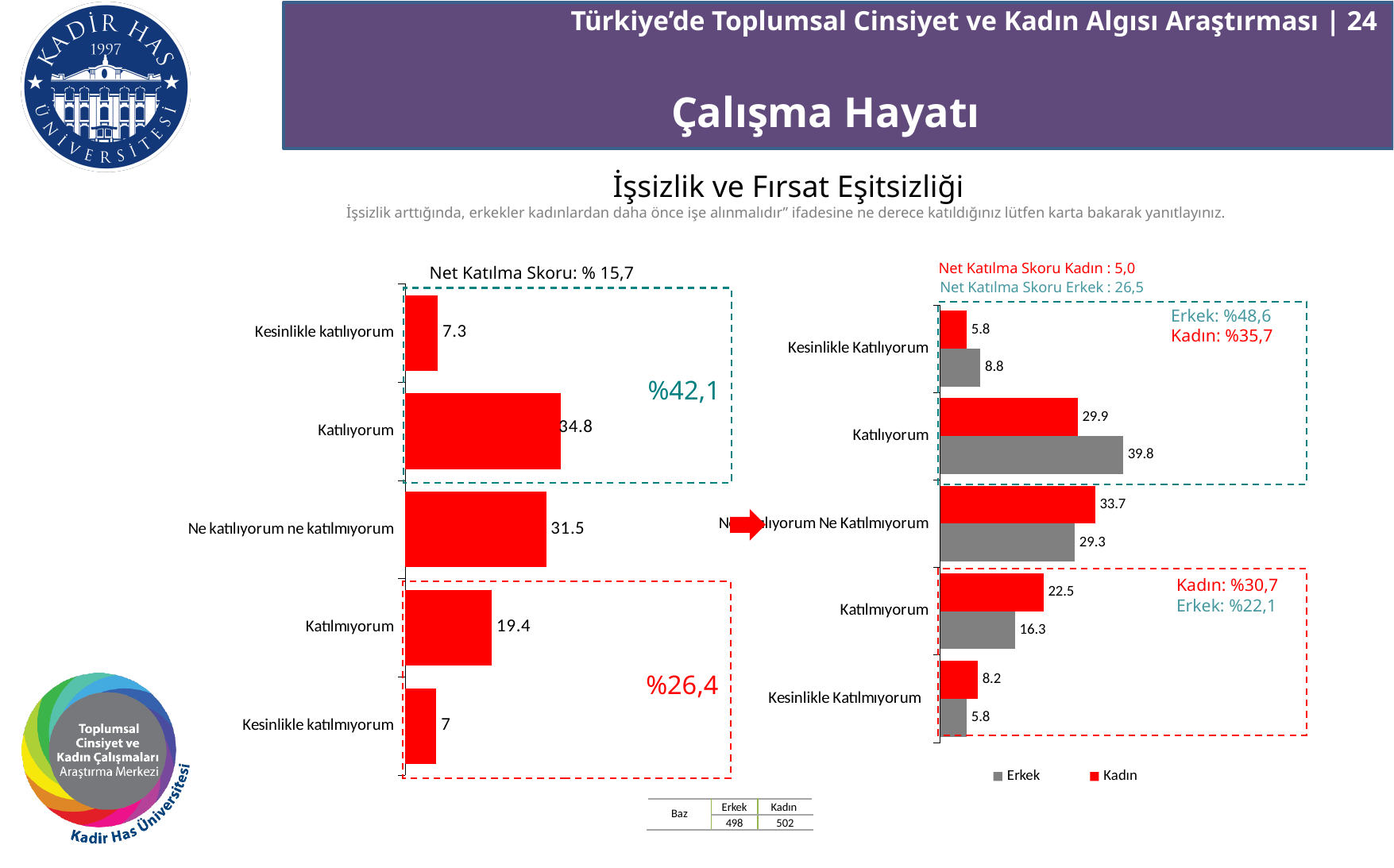
In the right chart, what is the difference between the Erkek and Kadın values for Katılıyorum? 9.9 In the left chart, how many categories are shown? 5 In the right chart, what is the Erkek value for Katılıyorum? 39.8 In the right chart, how many series does the legend list? 2 In the left chart, what is the value for Katılıyorum? 34.8 In the right chart, which is larger for Katılmıyorum, Erkek or Kadın? Kadın In the left chart, which category has the highest value? Katılıyorum In the right chart, what is the Kadın value for Ne Katılıyorum Ne Katılmıyorum? 33.7 In the left chart, which category has the lowest value? Kesinlikle katılmıyorum In the left chart, what is the difference between Katılıyorum and Katılmıyorum? 15.4 In the left chart, what is the value for Kesinlikle katılmıyorum? 7 What type of chart is the left chart? Bar chart